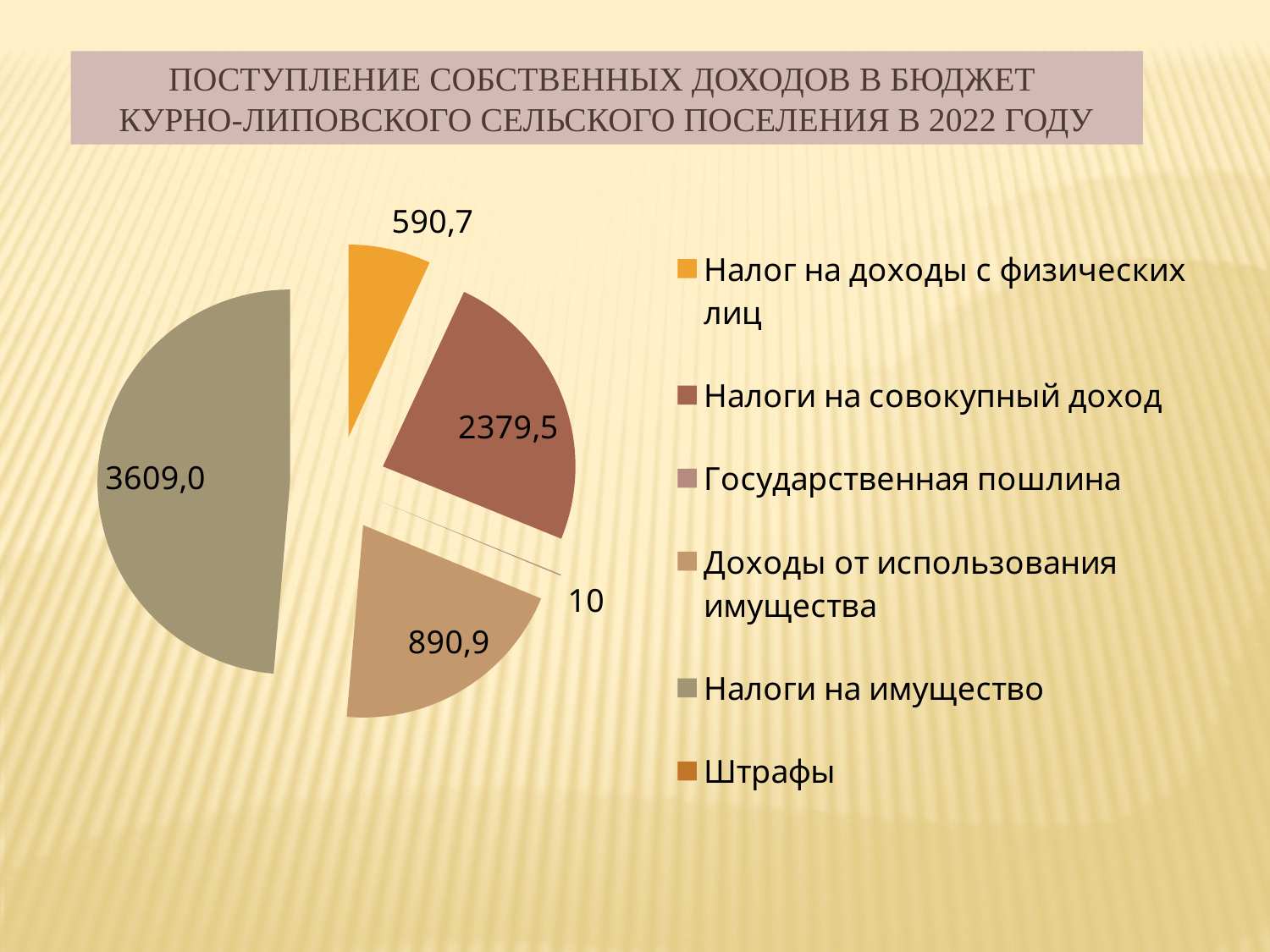
What colour is the slice for Налог на доходы с физических лиц? Orange How many entries does the legend list? 6 Which is larger: Налоги на совокупный доход or Доходы от использования имущества? Налоги на совокупный доход What is the difference between the values for Налоги на имущество and Налоги на совокупный доход? 1229,5 What is the value shown for Доходы от использования имущества? 890,9 What is the value shown for Налог на доходы с физических лиц? 590,7 Which category has the largest slice of the pie? Налоги на имущество What is the difference between the values for Доходы от использования имущества and Налог на доходы с физических лиц? 300,2 What type of chart is shown on the slide? Pie chart What is the value shown for Налоги на имущество? 3609,0 Which is larger: Налог на доходы с физических лиц or Доходы от использования имущества? Доходы от использования имущества What is the value shown for Налоги на совокупный доход? 2379,5